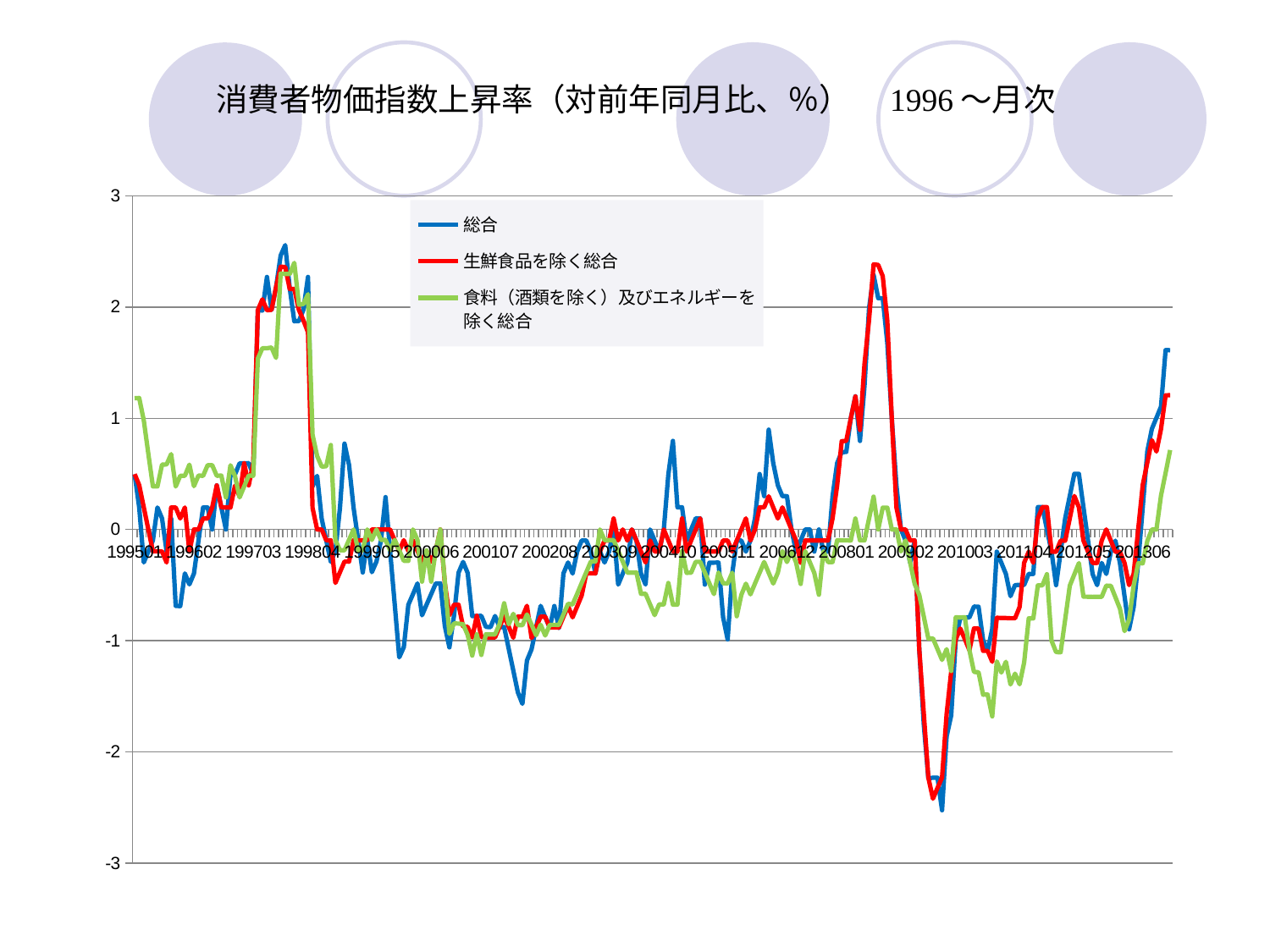
Is the peak of the 生鮮食品を除く総合 series around 200801 greater or less than 2? greater What kind of chart is shown on the slide? line chart Is the lowest value of the 総合 series around 200902 greater or less than -2? less Is the peak of the 総合 series between 199703 and 199804 greater or less than 2? greater Do the values of the 生鮮食品を除く総合 series rise or fall from 199804 to 199905? fall What is the title of the chart? 消費者物価指数上昇率（対前年同月比、%） 1996～月次 How many series does the legend list? 3 Which colour is used for the 総合 series? blue